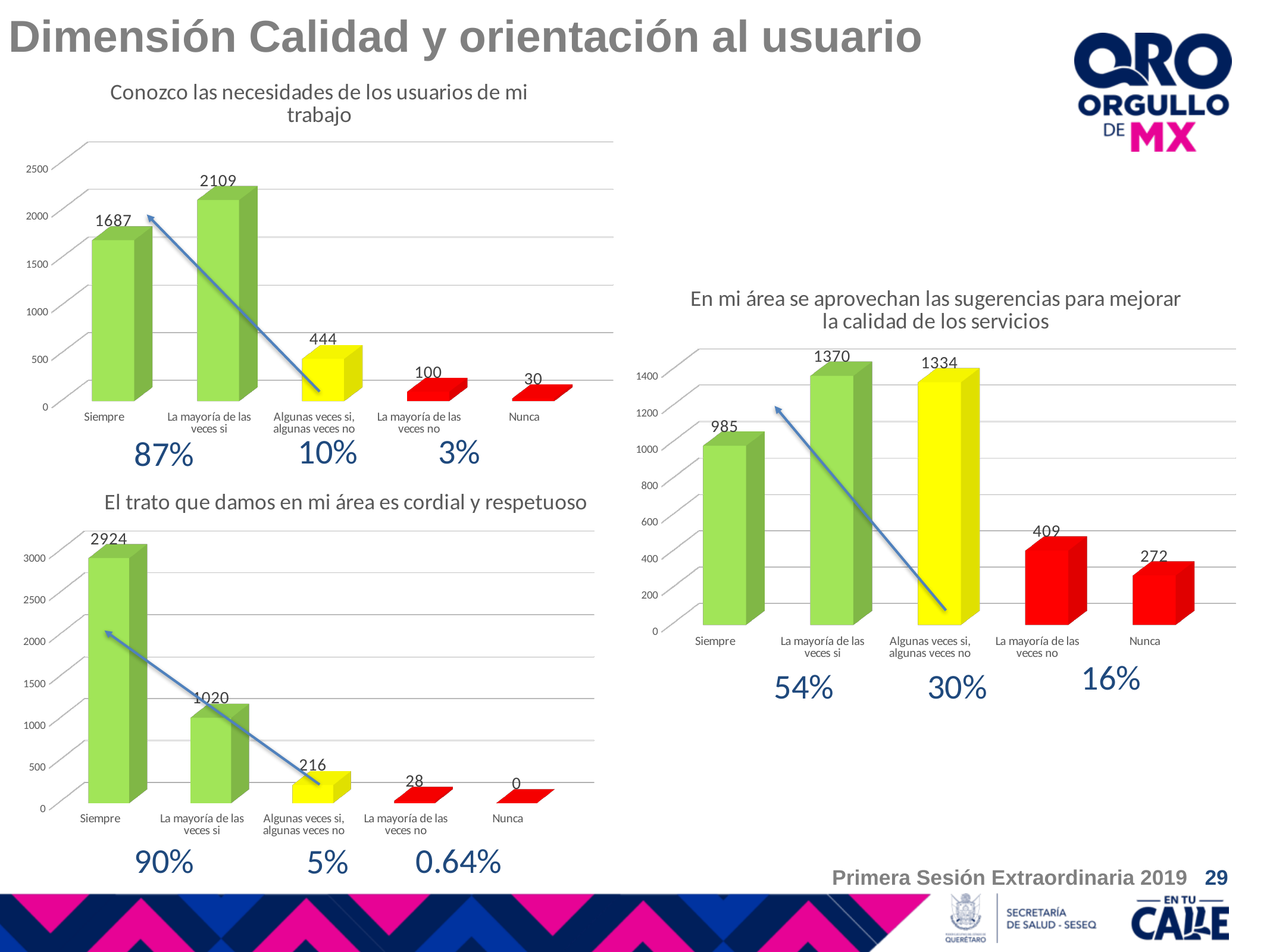
In the chart titled 'En mi área se aprovechan las sugerencias para mejorar la calidad de los servicios', which category has the highest value? La mayoría de las veces si What kind of chart is the chart titled 'Conozco las necesidades de los usuarios de mi trabajo'? bar chart In the chart titled 'El trato que damos en mi área es cordial y respetuoso', what is the value for 'Nunca'? 0 In the chart titled 'En mi área se aprovechan las sugerencias para mejorar la calidad de los servicios', what is the value for 'La mayoría de las veces no'? 409 In the chart titled 'En mi área se aprovechan las sugerencias para mejorar la calidad de los servicios', which is larger: 'Siempre' or 'Nunca'? Siempre In the chart titled 'El trato que damos en mi área es cordial y respetuoso', do the values rise or fall from left to right along the x axis? fall In the chart titled 'Conozco las necesidades de los usuarios de mi trabajo', what is the difference between 'La mayoría de las veces si' and 'Siempre'? 422 In the chart titled 'Conozco las necesidades de los usuarios de mi trabajo', which category has the lowest value? Nunca How many categories are shown on the x axis of the chart titled 'En mi área se aprovechan las sugerencias para mejorar la calidad de los servicios'? 5 In the chart titled 'El trato que damos en mi área es cordial y respetuoso', which category has the highest value? Siempre In the chart titled 'El trato que damos en mi área es cordial y respetuoso', what is the value for 'Siempre'? 2924 In the chart titled 'Conozco las necesidades de los usuarios de mi trabajo', what is the value for 'La mayoría de las veces si'? 2109